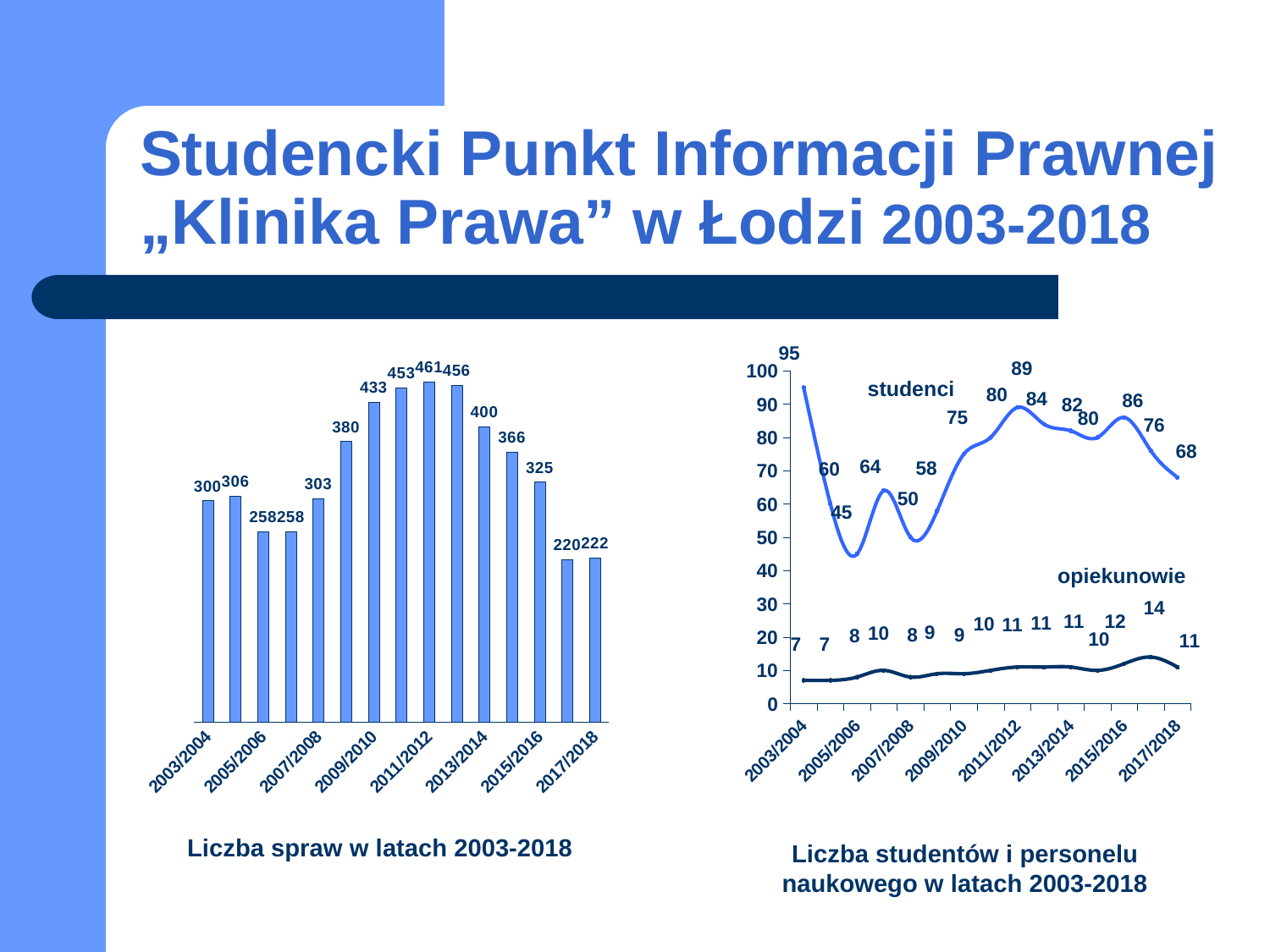
In the right chart, what is the highest value of the 'studenci' series? 95 In the right chart, is the 'studenci' value higher in 2009/2010 or in 2013/2014? 2013/2014 In the left chart 'Liczba spraw w latach 2003-2018', which year has the highest value? 2011/2012 What kind of chart is the right chart, 'Liczba studentów i personelu naukowego w latach 2003-2018'? line chart How many bars are there in the left chart 'Liczba spraw w latach 2003-2018'? 15 In the left chart 'Liczba spraw w latach 2003-2018', what is the difference between the values for 2003/2004 and 2017/2018? 78 What kind of chart is the left chart, 'Liczba spraw w latach 2003-2018'? bar chart In the left chart 'Liczba spraw w latach 2003-2018', what is the lowest value shown? 220 In the right chart, what is the value of the 'opiekunowie' series for 2017/2018? 11 In the left chart 'Liczba spraw w latach 2003-2018', what is the value for 2011/2012? 461 How many series are plotted in the right chart 'Liczba studentów i personelu naukowego w latach 2003-2018'? 2 In the right chart, what is the value of the 'studenci' series for 2003/2004? 95